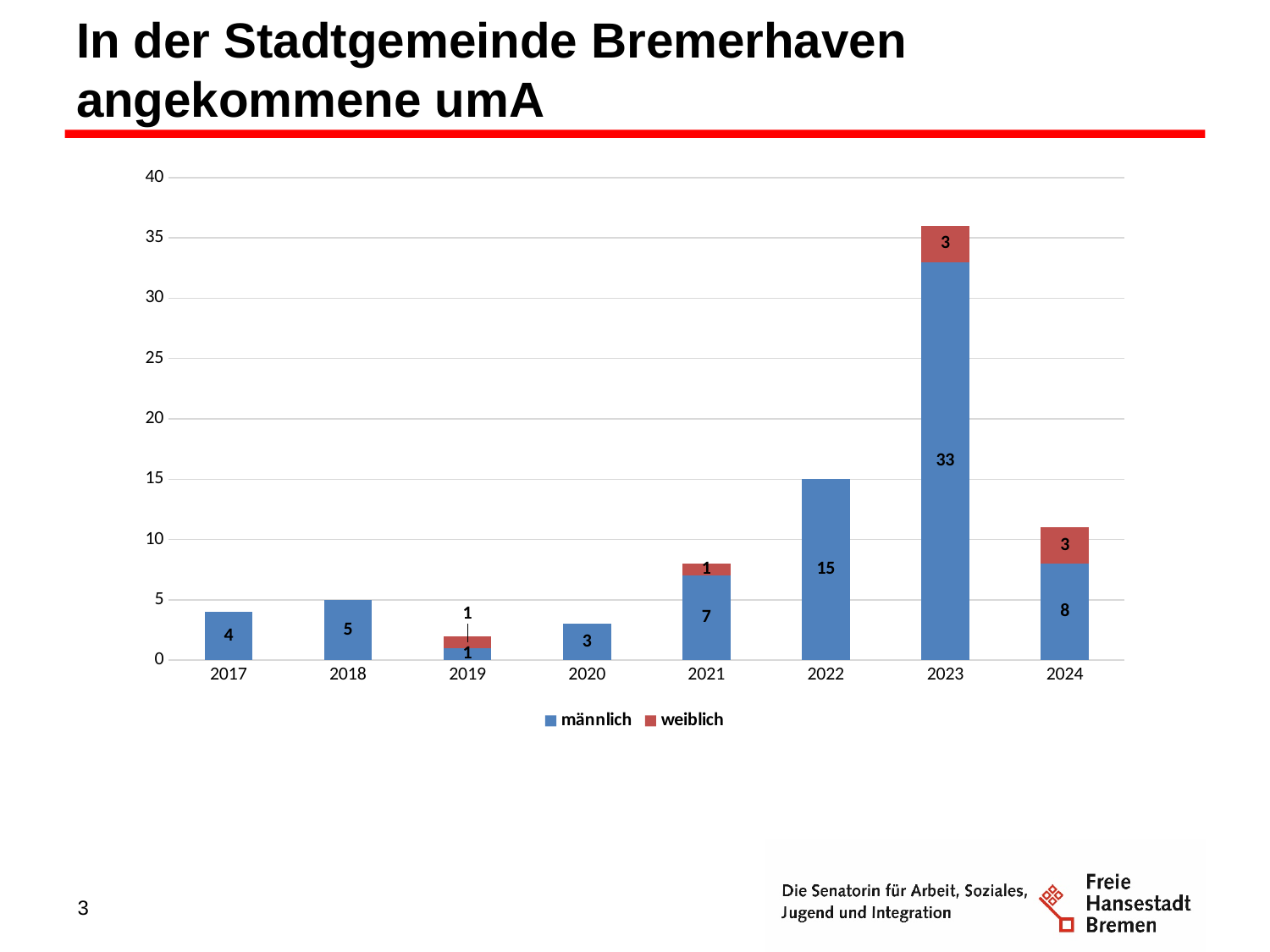
What is the difference between the männlich values for 2023 and 2022? 18 How many years are shown on the x axis? 8 Which year has the lowest männlich value? 2019 Which is larger, the männlich value for 2021 or for 2024? 2024 What is the total of the stacked bar for 2023? 36 What is the männlich value for 2023? 33 Which year has the highest männlich value? 2023 What is the weiblich value for 2024? 3 How many series does the legend list? 2 What is the männlich value for 2022? 15 What is the total of the stacked bar for 2024? 11 What kind of chart is shown on the slide? Stacked bar chart